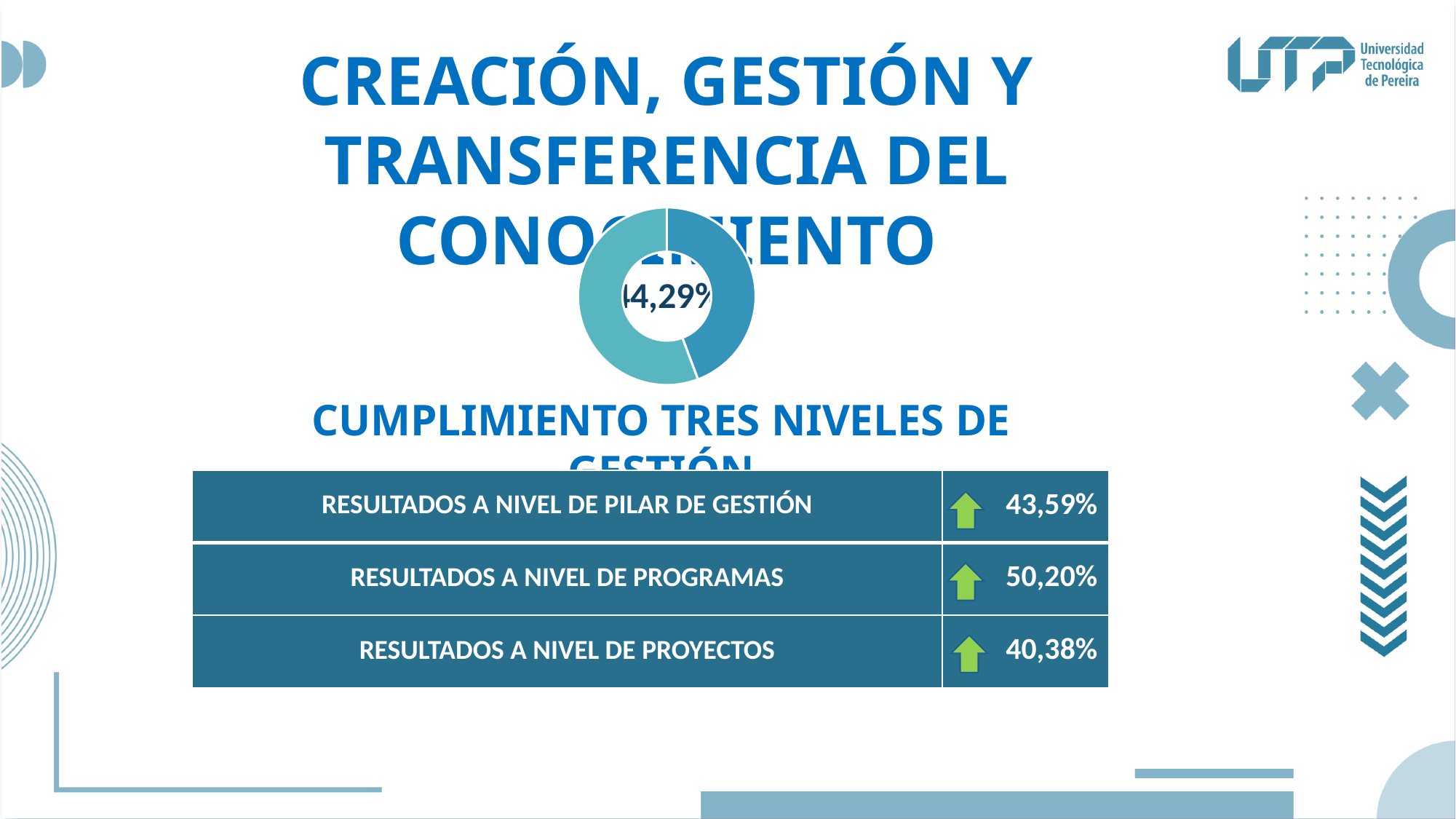
How many colours are used for the slices of the doughnut chart? 2 What percentage value is printed in the centre of the doughnut chart? 44,29% Is the value printed in the centre of the doughnut chart greater or less than 50%? less What kind of chart is shown on the slide? doughnut chart How many slices does the doughnut chart have? 2 Does the doughnut chart display a legend? No Which slice of the doughnut chart is larger, the light teal one or the dark blue one? the light teal one